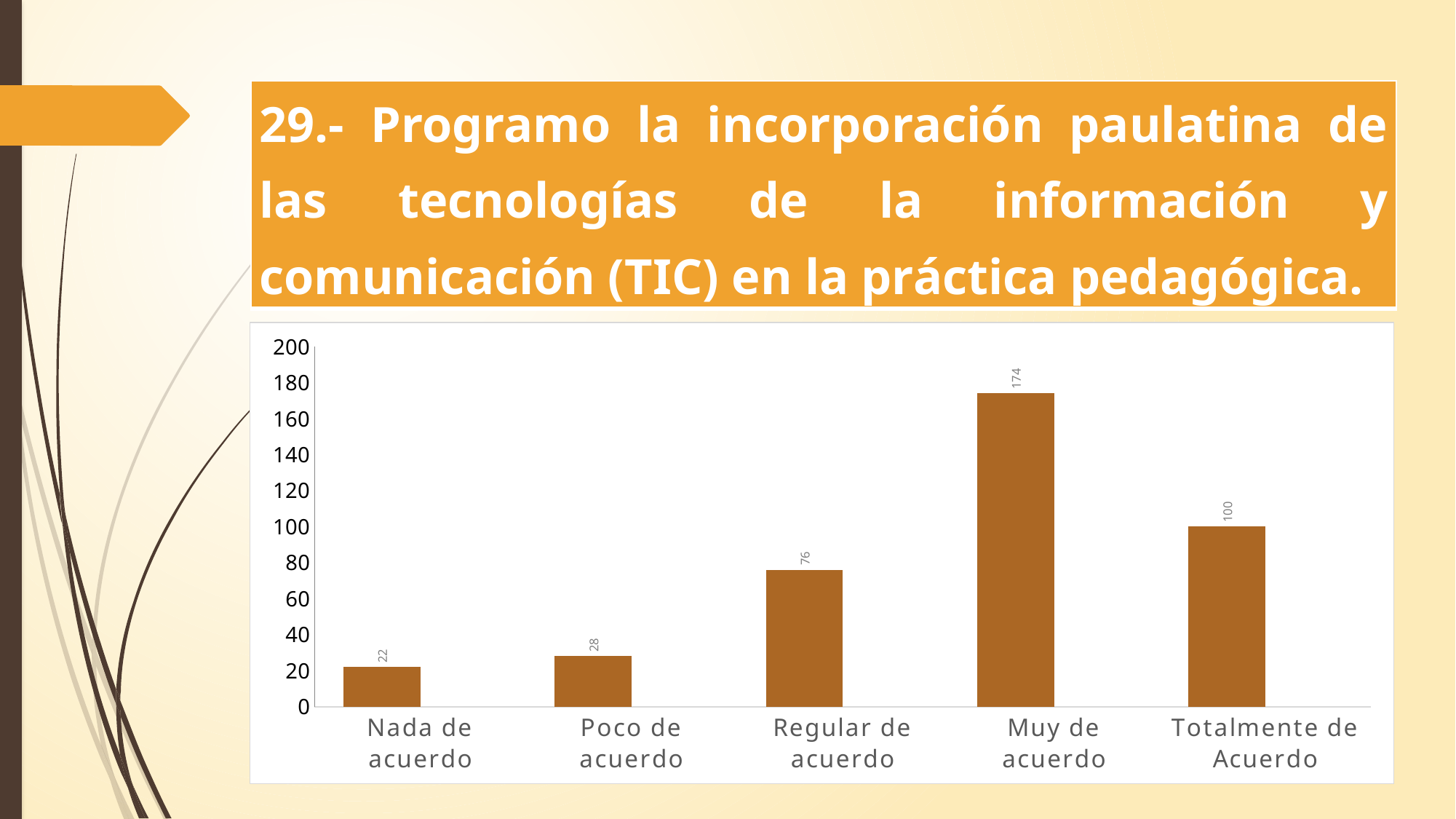
What is the highest value shown on the vertical axis? 200 What is the difference between the values for "Muy de acuerdo" and "Totalmente de Acuerdo"? 74 Which category has the lowest value? Nada de acuerdo What kind of chart is shown on the slide? Bar chart How many categories are shown on the x axis? 5 What is the difference between the values for "Poco de acuerdo" and "Nada de acuerdo"? 6 What is the value for "Totalmente de Acuerdo"? 100 Which category has the highest value? Muy de acuerdo Which is larger, the value for "Regular de acuerdo" or the value for "Totalmente de Acuerdo"? Totalmente de Acuerdo What is the value for "Nada de acuerdo"? 22 What is the value for "Muy de acuerdo"? 174 What is the value for "Regular de acuerdo"? 76